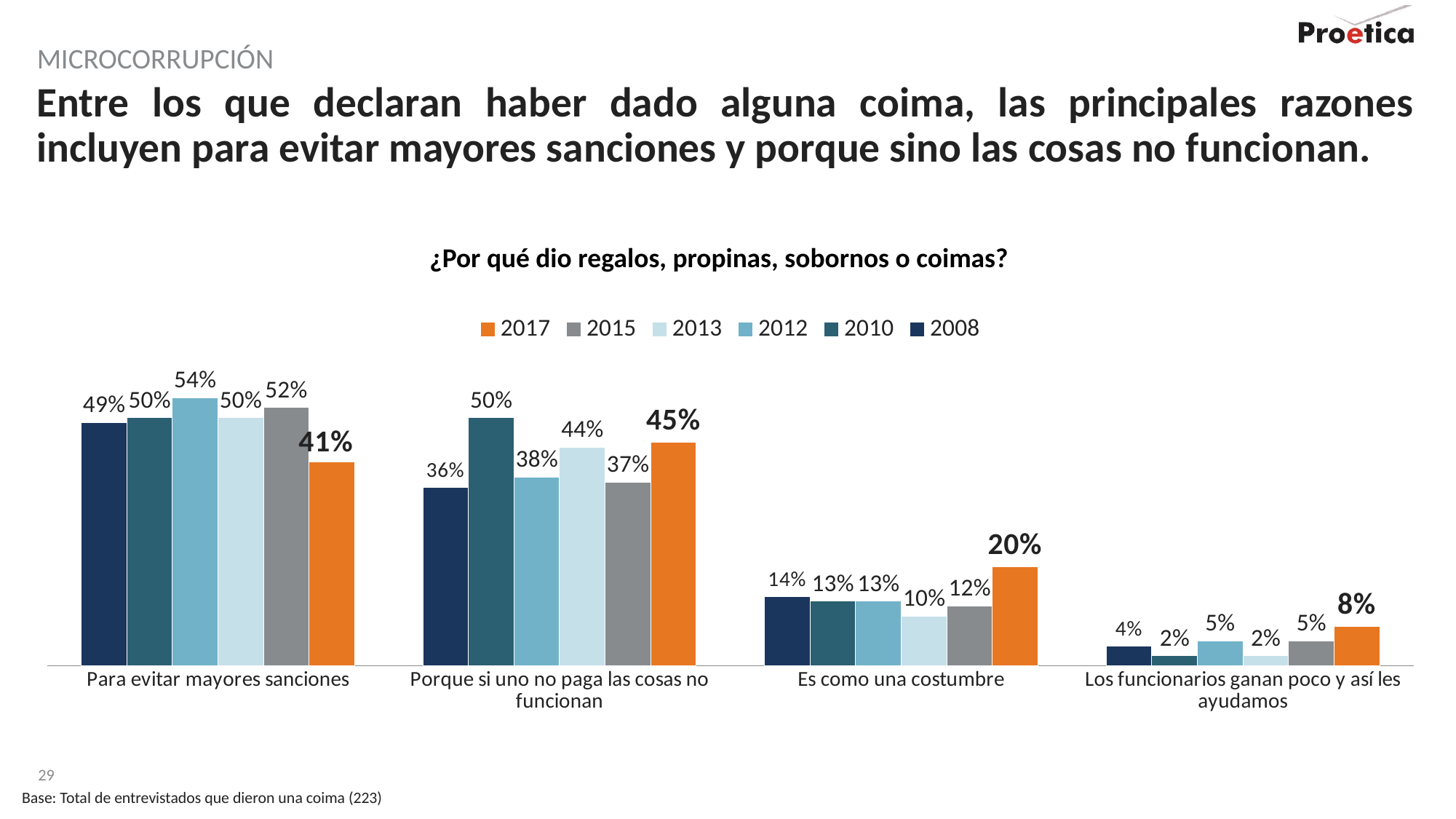
How many series does the legend list? 6 What is the 2012 value for "Los funcionarios ganan poco y así les ayudamos"? 5% What is the title of the chart? ¿Por qué dio regalos, propinas, sobornos o coimas? What is the 2017 value for "Es como una costumbre"? 20% What is the difference between the 2017 and 2015 values for "Es como una costumbre"? 8% Which is larger for "Porque si uno no paga las cosas no funcionan": the 2013 value or the 2015 value? 2013 Which category has the lowest 2017 value? Los funcionarios ganan poco y así les ayudamos How many categories are shown on the x axis? 4 What is the 2010 value for "Porque si uno no paga las cosas no funcionan"? 50% What kind of chart is shown on the slide? Bar chart Which year has the highest value for "Para evitar mayores sanciones"? 2012 What is the 2017 value for "Para evitar mayores sanciones"? 41%